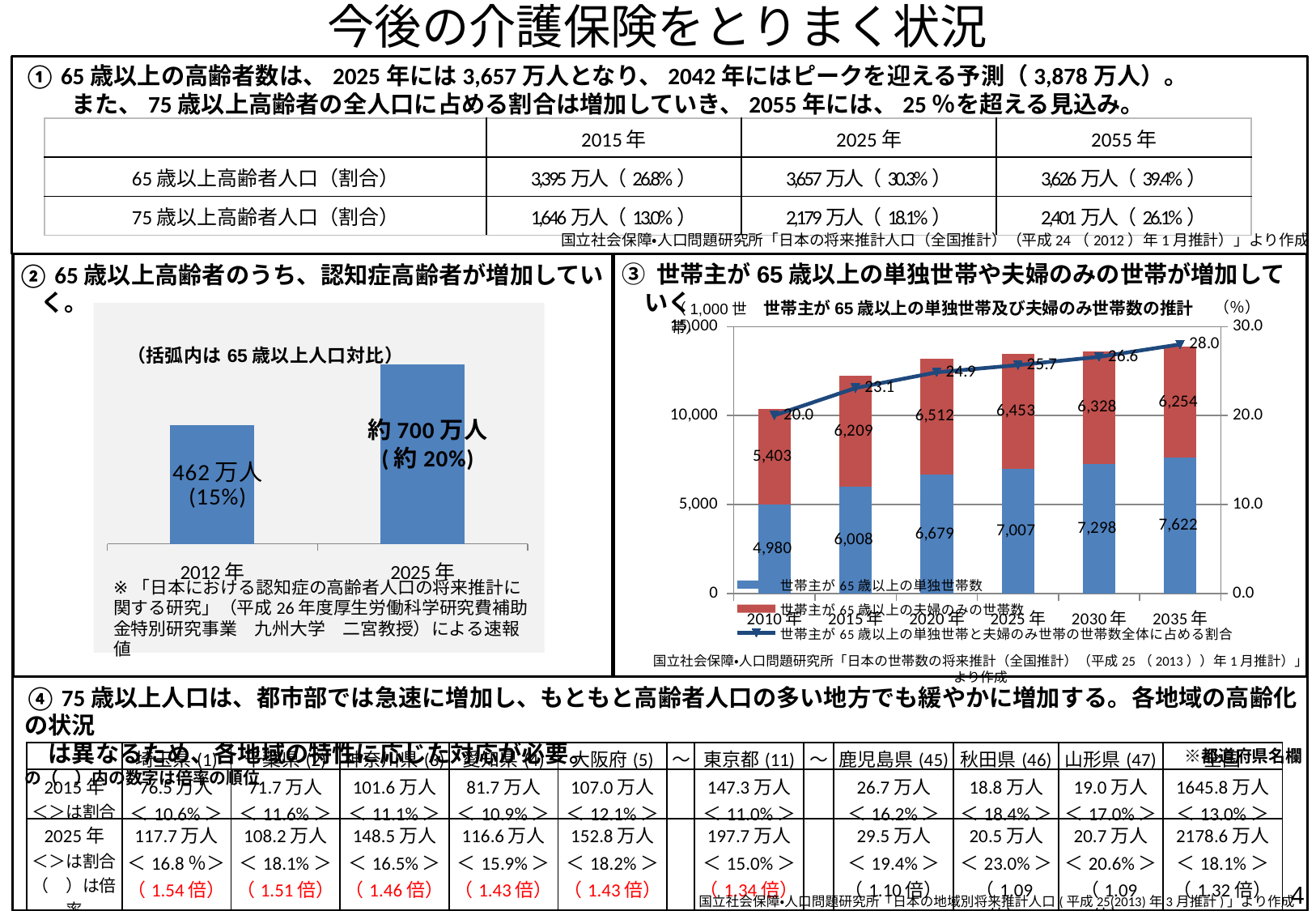
In the chart titled 世帯主が65歳以上の単独世帯及び夫婦のみ世帯数の推移, what percentage does the line show for 2035年? 28.0 In the chart titled 世帯主が65歳以上の単独世帯及び夫婦のみ世帯数の推移, how many years are shown on the x axis? 6 In the chart titled 世帯主が65歳以上の単独世帯及び夫婦のみ世帯数の推移, does the line for the share of 単独世帯と夫婦のみ世帯 rise or fall from 2010年 to 2035年? rise In the chart titled 世帯主が65歳以上の単独世帯及び夫婦のみ世帯数の推移, which year has the highest value for 世帯主が65歳以上の単独世帯数? 2035年 In the bar chart in section ② on the left, which year has the higher bar, 2012年 or 2025年? 2025年 In the bar chart in section ② on the left, what is the value shown for 2012年? 462万人 (15%) In the chart titled 世帯主が65歳以上の単独世帯及び夫婦のみ世帯数の推移, which year has the lowest value for 世帯主が65歳以上の夫婦のみの世帯数? 2010年 In the chart titled 世帯主が65歳以上の単独世帯及び夫婦のみ世帯数の推移, what is the total of the stacked bar for 2025年? 13,460 In the chart titled 世帯主が65歳以上の単独世帯及び夫婦のみ世帯数の推移, what is the difference between the 単独世帯数 values for 2035年 and 2010年? 2,642 In the chart titled 世帯主が65歳以上の単独世帯及び夫婦のみ世帯数の推移, what is the value of 世帯主が65歳以上の夫婦のみの世帯数 for 2020年? 6,512 In the chart titled 世帯主が65歳以上の単独世帯及び夫婦のみ世帯数の推移, how many series does the legend list? 3 In the chart titled 世帯主が65歳以上の単独世帯及び夫婦のみ世帯数の推移, what is the value of 世帯主が65歳以上の単独世帯数 for 2010年? 4,980